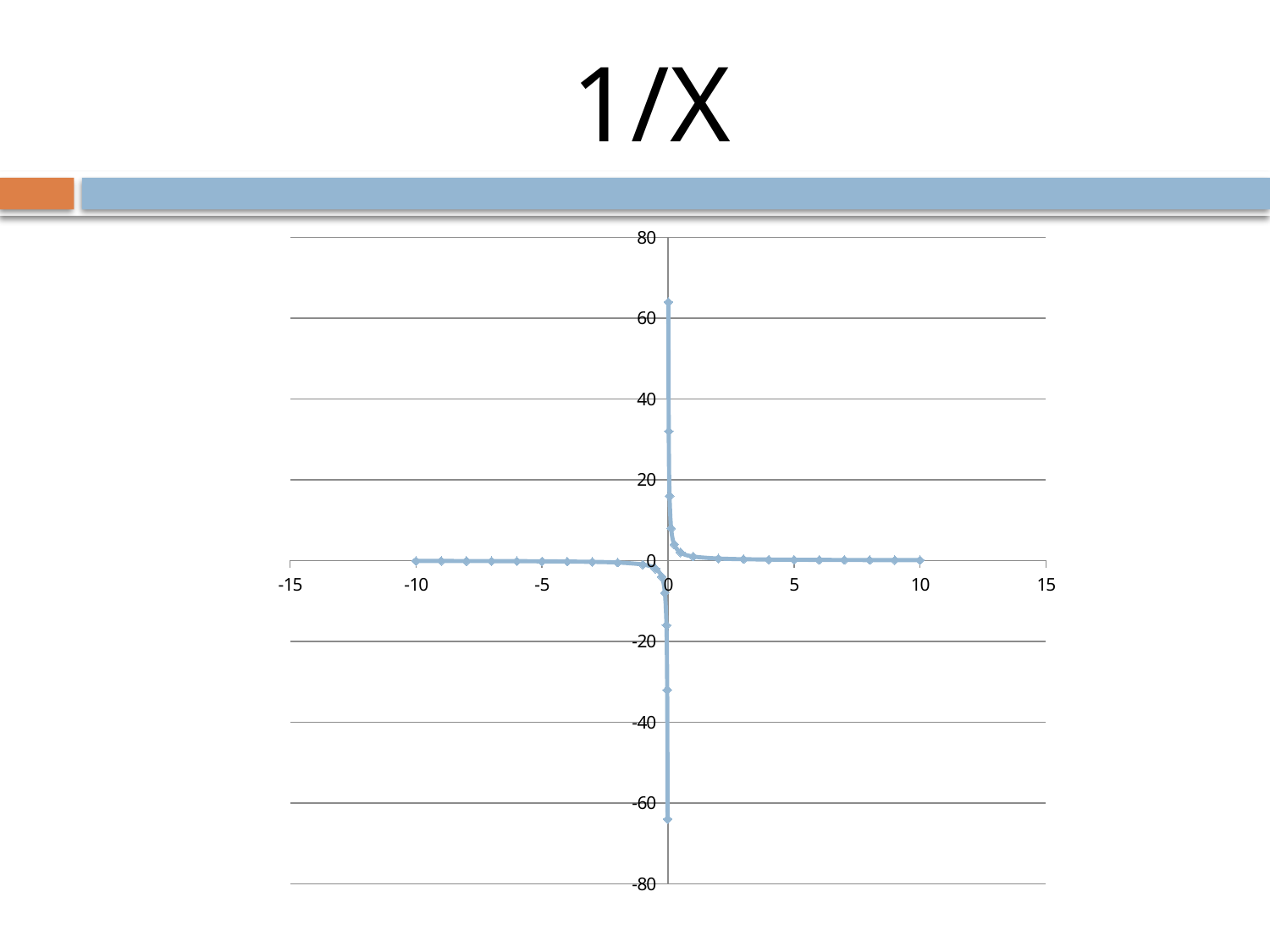
What is the highest tick label on the vertical axis? 80 Is the highest plotted value on the chart greater or less than 40? greater Is the plotted value at x = -10 greater or less than -20? greater Is the plotted value just to the right of x = 0 greater or less than 0? greater What is the title of the chart? 1/X Which is larger, the plotted value at x = 5 or the plotted value at x = -5? x = 5 As x increases from 1 to 10, do the plotted values rise or fall? fall As x increases from -10 to -1, do the plotted values rise or fall? fall What kind of chart is shown on the slide? Scatter chart with lines and markers